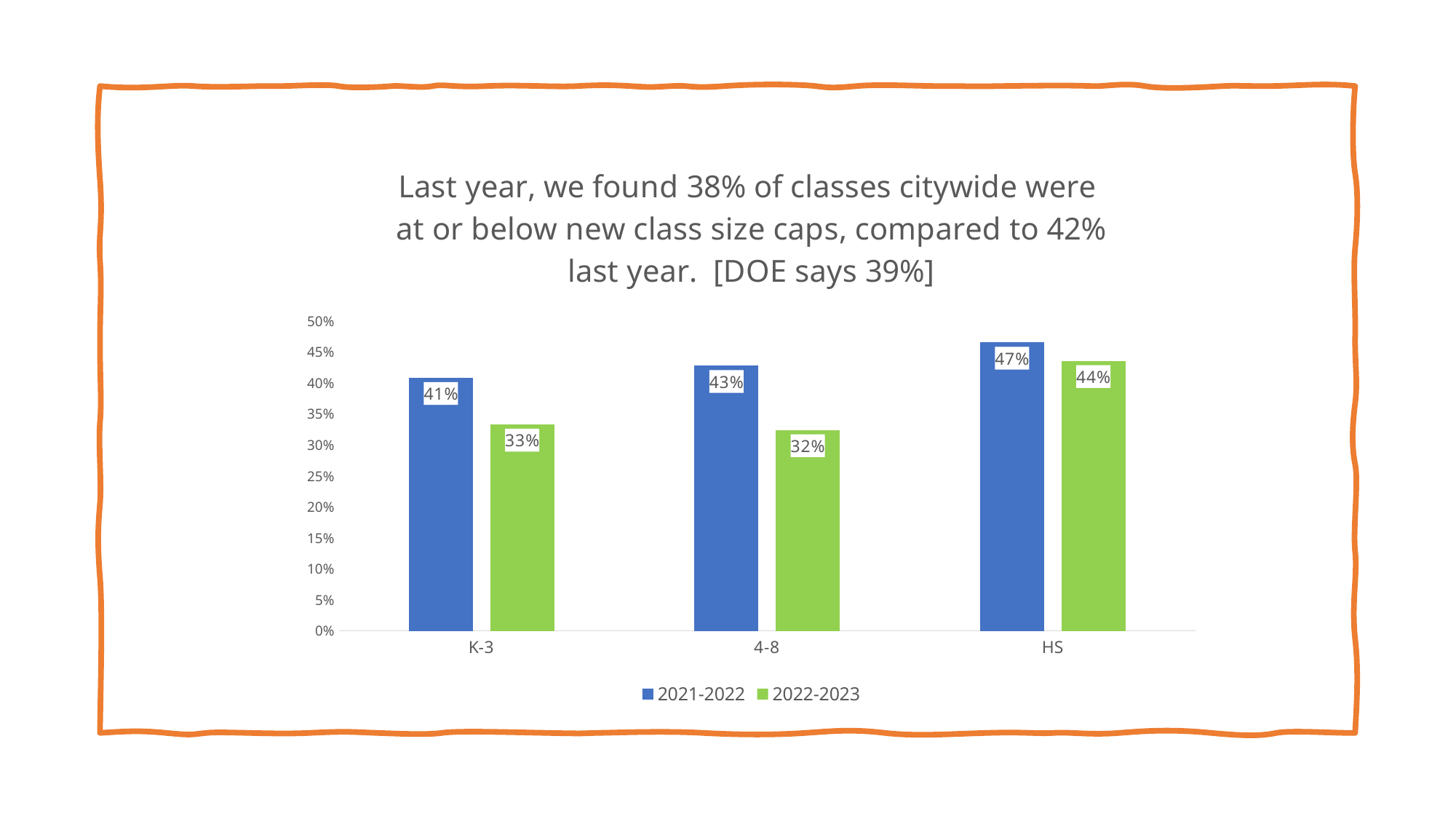
What kind of chart is shown on the slide? bar chart What is the value for HS in the 2021-2022 series? 47% Is the value for K-3 in the 2022-2023 series greater or less than 35%? less Which category has the lowest value in the 2021-2022 series? K-3 What is the difference between the 2021-2022 and 2022-2023 values for 4-8? 11% Which is larger for HS: the 2021-2022 value or the 2022-2023 value? 2021-2022 Which category has the highest value in the 2022-2023 series? HS How many categories are shown on the x axis? 3 How many series does the legend list? 2 What is the value for 4-8 in the 2022-2023 series? 32% What is the value for K-3 in the 2021-2022 series? 41% Which colour represents the 2022-2023 series? green